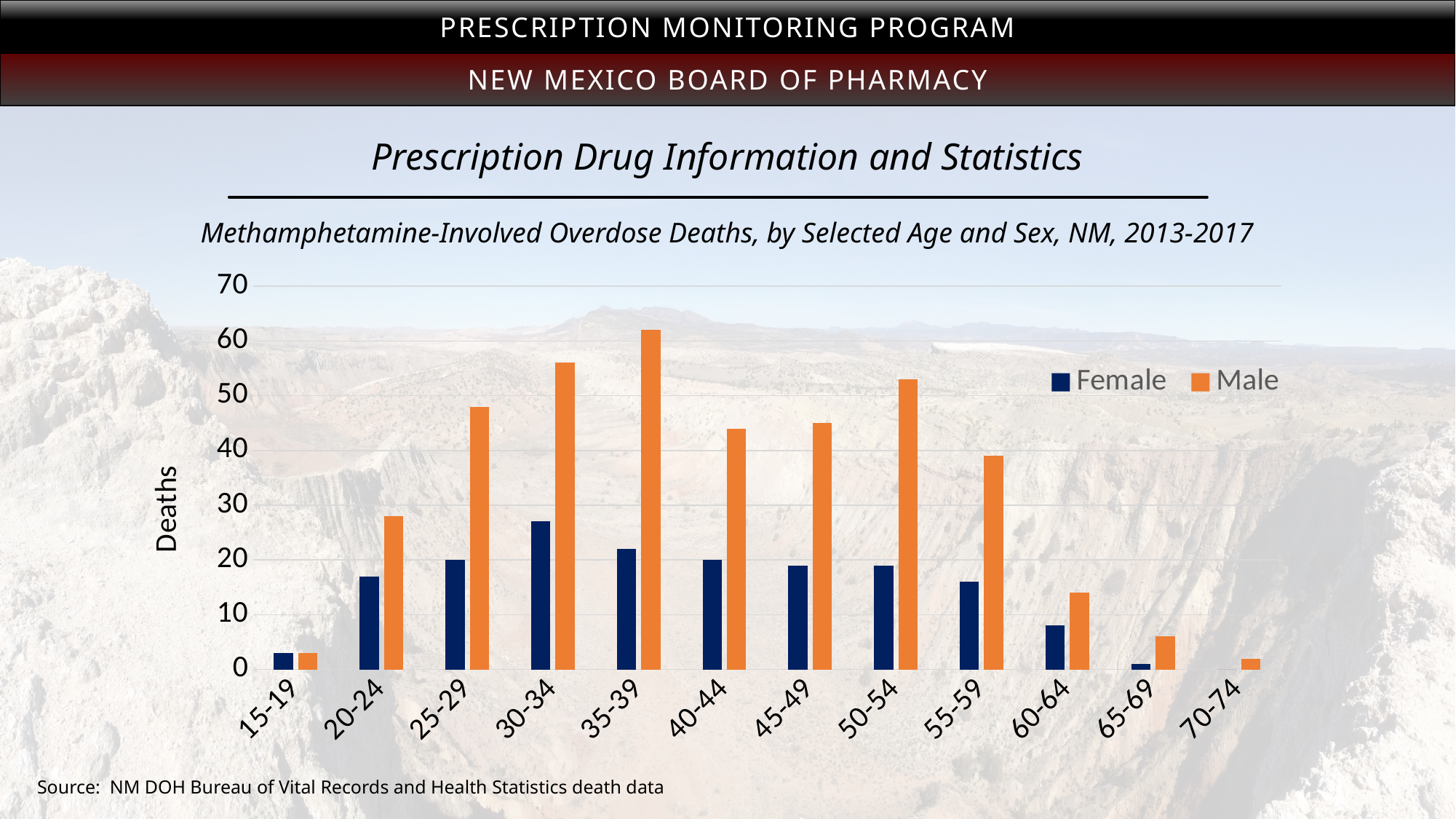
Is the Female value for 60-64 greater or less than 10? less How many series does the legend list? 2 Is the Female value for 30-34 greater or less than 20? greater What kind of chart is shown on the slide? bar chart Which is larger, the Male value for 25-29 or the Male value for 55-59? 25-29 How many age groups are shown on the x axis? 12 What colour are the Male bars in the chart? orange Is the Male value for 35-39 greater or less than 60? greater Which age group has the highest number of Male deaths? 35-39 Which age group has the highest number of Female deaths? 30-34 Do the Male values rise or fall from the 35-39 age group to the 70-74 age group? fall